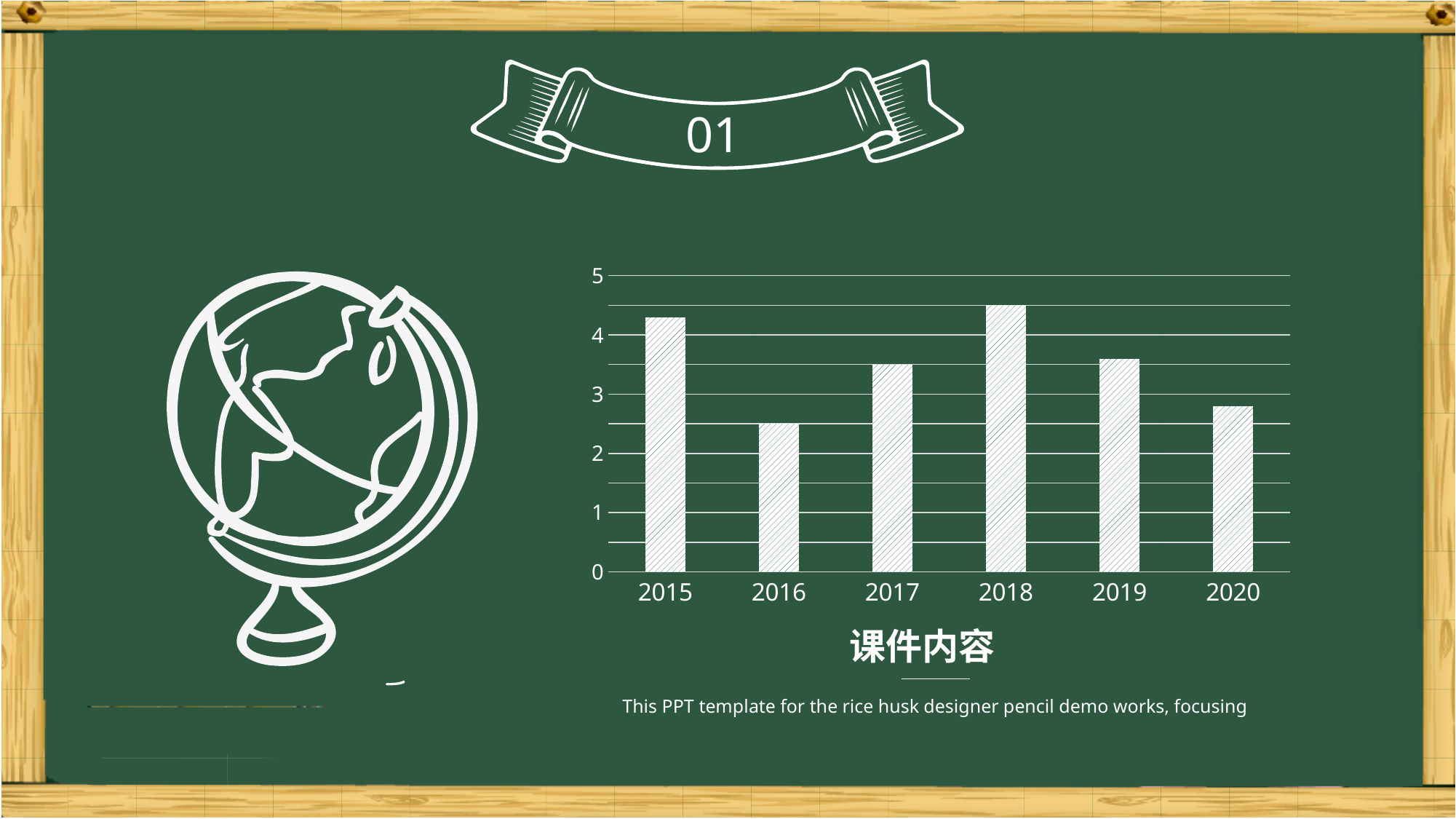
Is the value for 2016 greater or less than 3? less Is the value for 2020 greater or less than 3? less Is the value for 2015 greater or less than 4? greater Do the values rise or fall from 2018 to 2020? fall Which year has the highest bar in the chart? 2018 How many years are shown on the x axis of the chart? 6 Which year has the lowest bar in the chart? 2016 Which is larger, the value for 2016 or the value for 2020? 2020 Which is larger, the value for 2015 or the value for 2020? 2015 What kind of chart is shown on the slide? bar chart